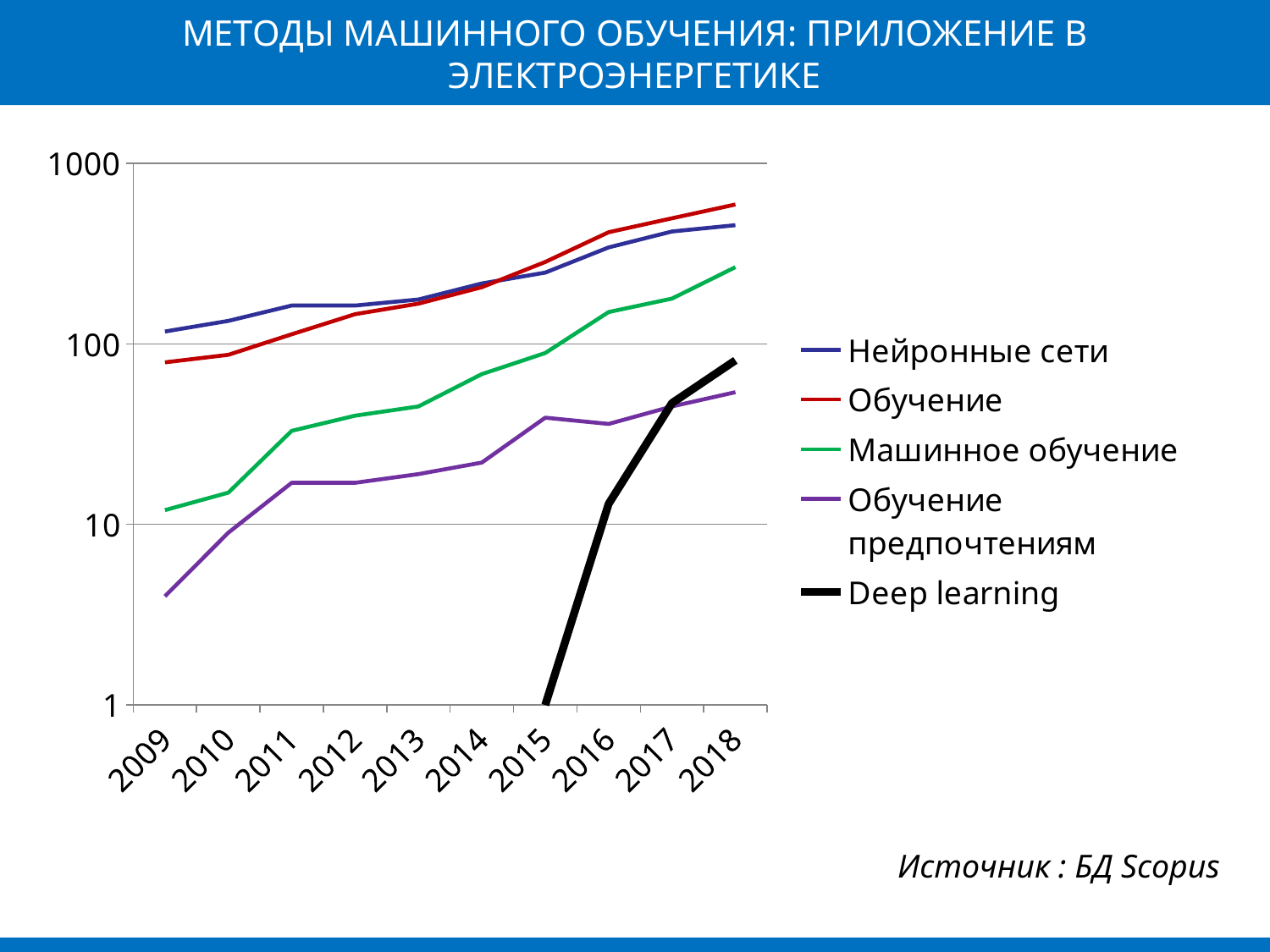
In 2009, which is larger: the value for Нейронные сети or the value for Обучение? Нейронные сети Is the value for Deep learning in 2018 greater or less than 100? less Which series has the lowest value in 2016? Deep learning How many series does the legend list? 5 Is the value for Нейронные сети in 2009 greater or less than 100? greater Is the value for Машинное обучение in 2018 greater or less than 100? greater What kind of chart is shown on the slide? line chart Does the Машинное обучение series rise or fall from 2009 to 2018? rise Which series has the highest value in 2018? Обучение How many years are shown along the x axis? 10 Which series has the lowest value in 2009? Обучение предпочтениям